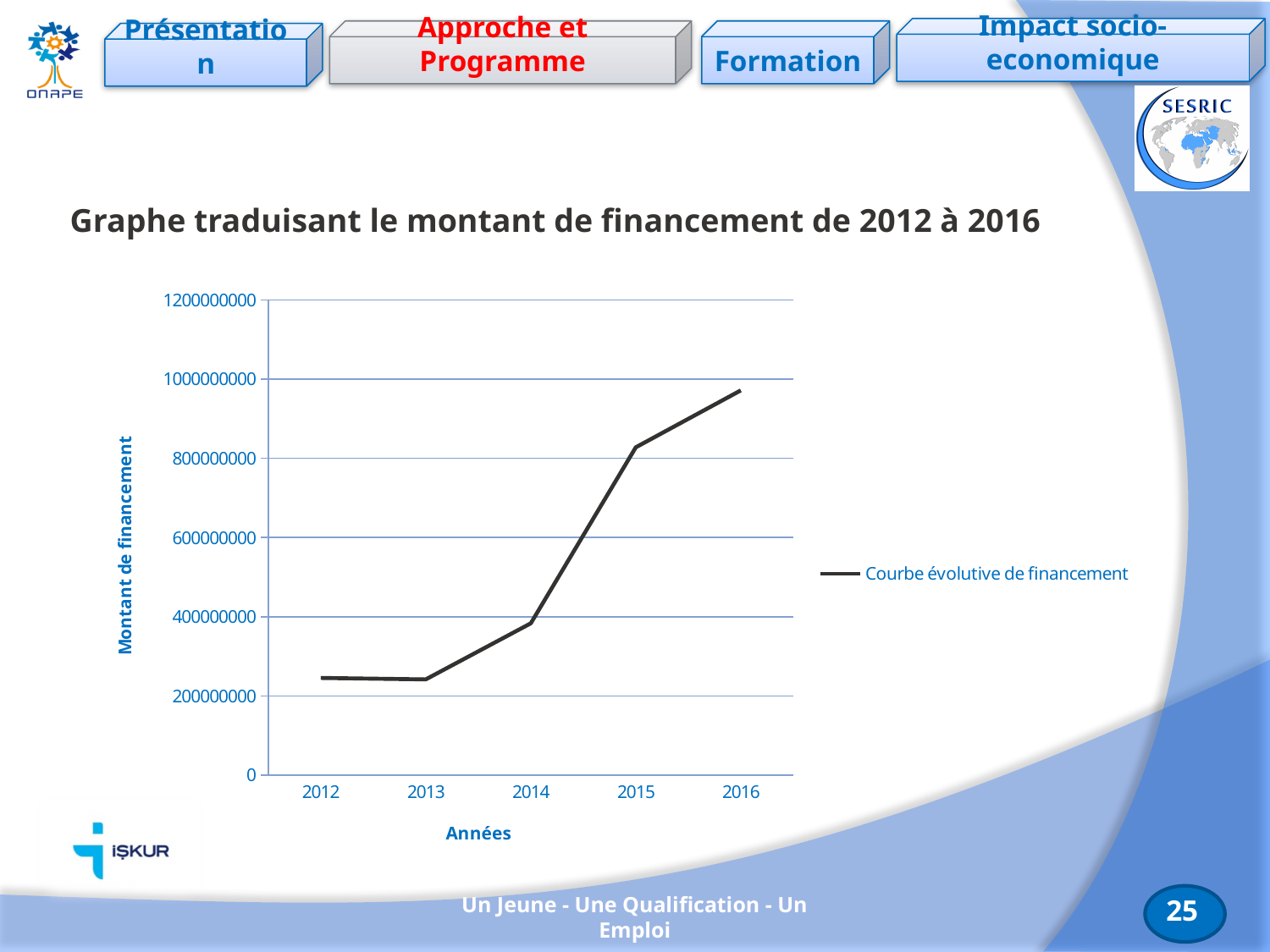
How many years are plotted along the x axis? 5 What is the name of the series shown in the legend? Courbe évolutive de financement What kind of chart is shown on the slide? line chart What is the title of the y axis? Montant de financement Which year has the larger financing amount, 2014 or 2015? 2015 Is the value for 2015 greater or less than 800000000? greater Which year has the highest financing amount? 2016 Is the value for 2016 greater or less than 800000000? greater Does the financing amount rise or fall from 2013 to 2016? rise How many series does the legend list? 1 Is the value for 2012 greater or less than 400000000? less